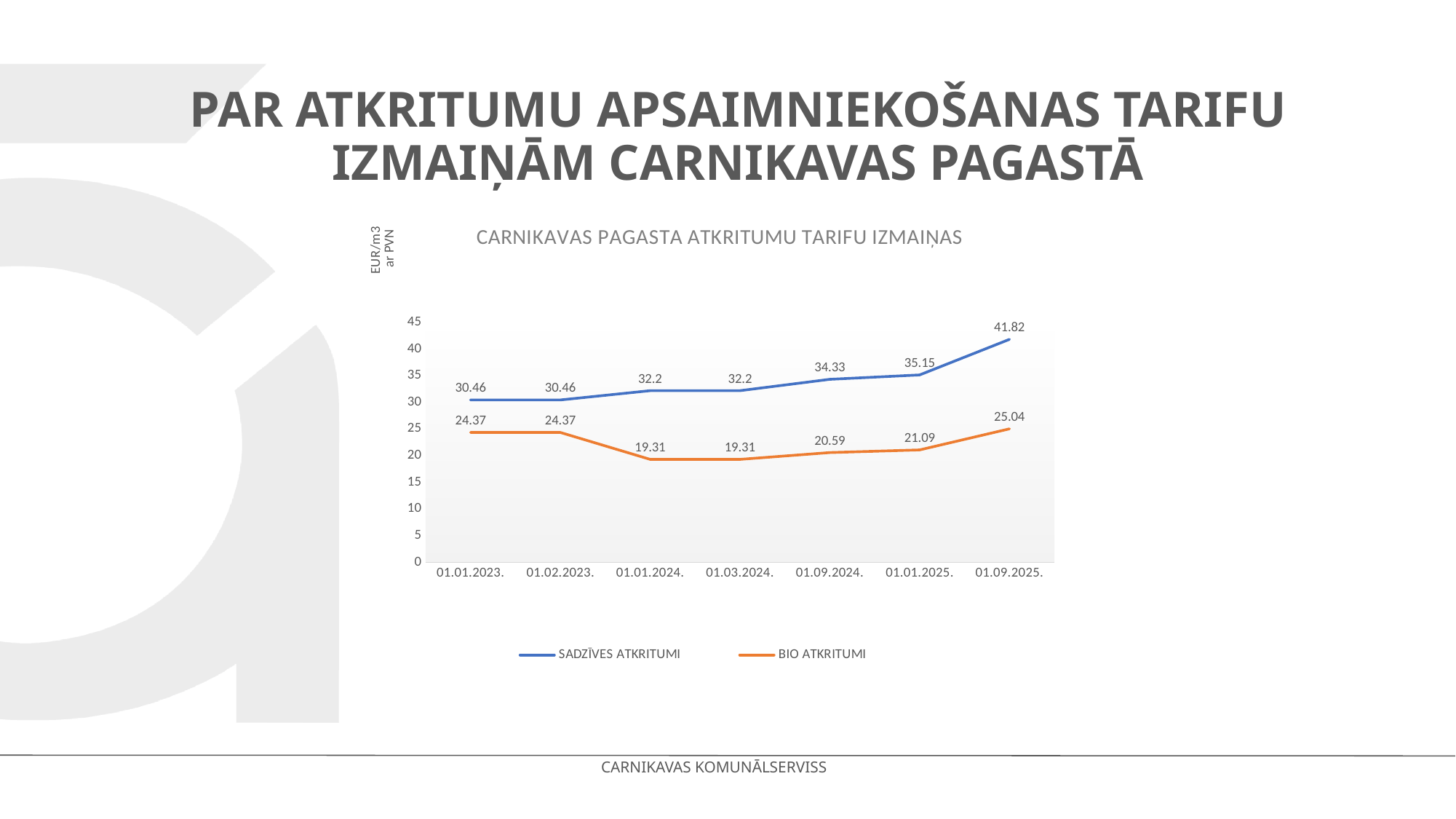
How many dates are shown on the x axis? 7 What is the value for SADZĪVES ATKRITUMI on 01.09.2025.? 41.82 What is the lowest value shown for BIO ATKRITUMI? 19.31 On which date is the SADZĪVES ATKRITUMI value highest? 01.09.2025. How many series does the legend list? 2 What is the title of the chart? CARNIKAVAS PAGASTA ATKRITUMU TARIFU IZMAIŅAS What is the value for BIO ATKRITUMI on 01.01.2025.? 21.09 What is the difference between the SADZĪVES ATKRITUMI and BIO ATKRITUMI values on 01.09.2025.? 16.78 What is the value for SADZĪVES ATKRITUMI on 01.09.2024.? 34.33 What kind of chart is shown? line chart What is the value for BIO ATKRITUMI on 01.01.2024.? 19.31 Which series has the larger value on 01.01.2023., SADZĪVES ATKRITUMI or BIO ATKRITUMI? SADZĪVES ATKRITUMI